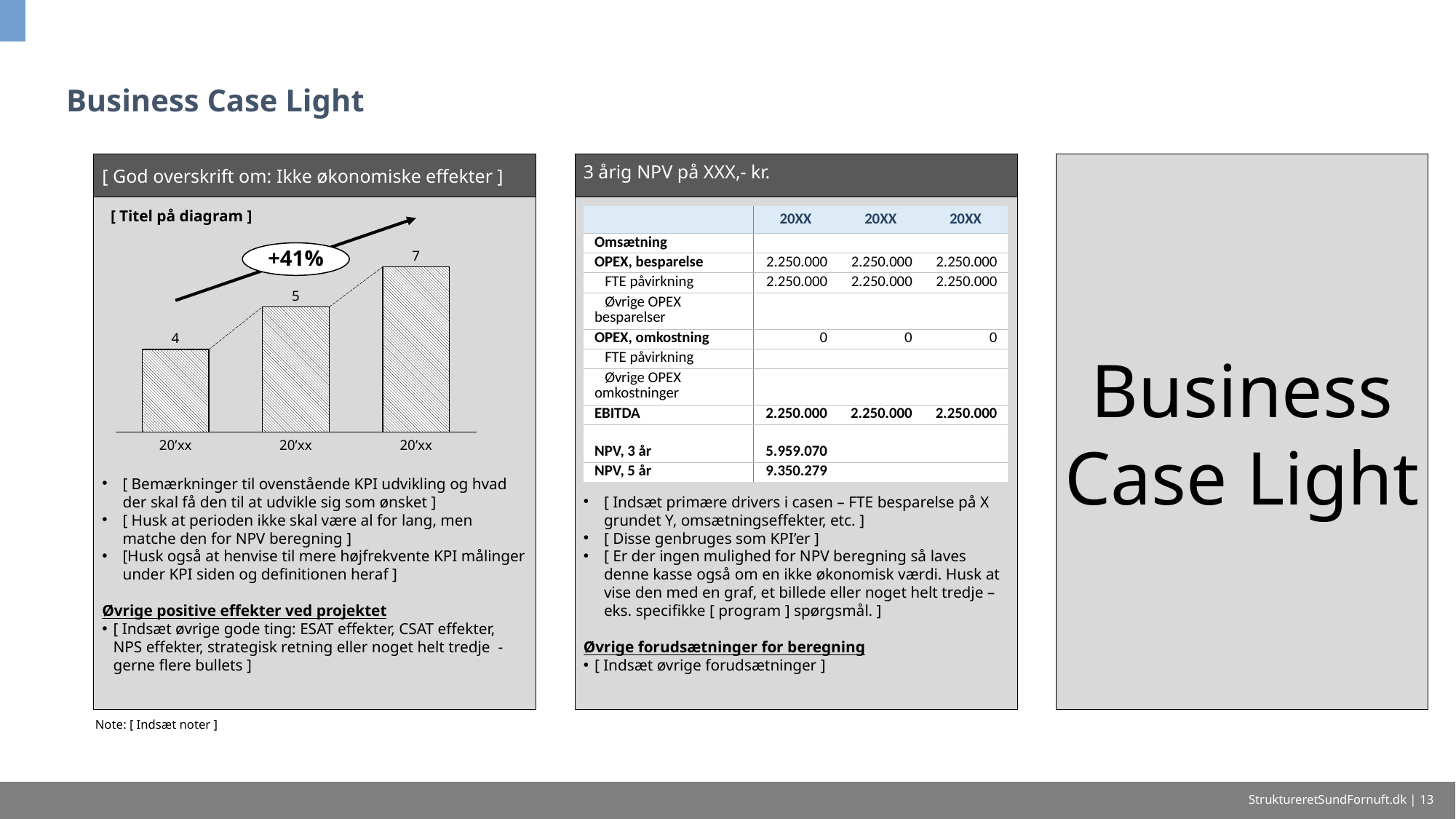
Do the bar values rise or fall from left to right in the chart? rise What is the value of the third (rightmost) bar in the chart? 7 What kind of chart is shown in the left panel under "[ Titel på diagram ]"? bar chart How many bars does the chart in the left panel have? 3 Which bar in the chart has the highest value? the third (rightmost) bar What is the value of the first (leftmost) bar in the chart? 4 Which is larger in the chart: the middle bar or the rightmost bar? the rightmost bar What is the value of the middle bar in the chart? 5 What is the difference between the rightmost bar and the leftmost bar in the chart? 3 Which bar in the chart has the lowest value? the first (leftmost) bar What percentage is shown in the oval annotation above the bars in the chart? +41% What label is used for each category on the x axis of the chart? 20'xx